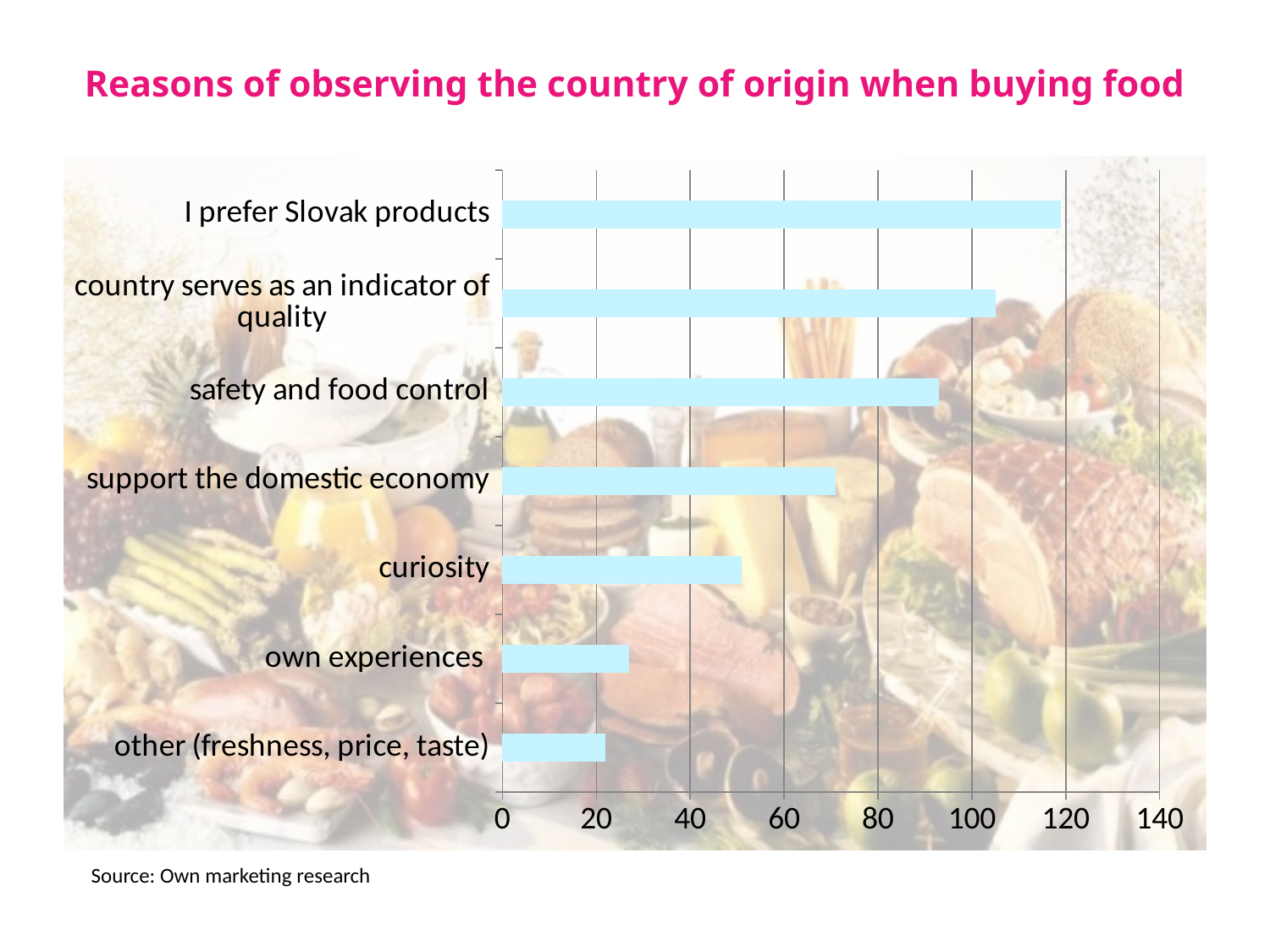
Is the value for 'I prefer Slovak products' greater or less than 100? greater Which reason has the lowest value in the chart? other (freshness, price, taste) How many categories (reasons) are shown in the chart? 7 Which is larger: the value for 'curiosity' or the value for 'own experiences'? curiosity What is the title of the chart on the slide? Reasons of observing the country of origin when buying food Is the value for 'safety and food control' greater or less than 100? less Is the value for 'own experiences' greater or less than 40? less Which is larger: the value for 'country serves as an indicator of quality' or the value for 'safety and food control'? country serves as an indicator of quality What kind of chart is shown on the slide? bar chart Which reason has the highest value in the chart? I prefer Slovak products